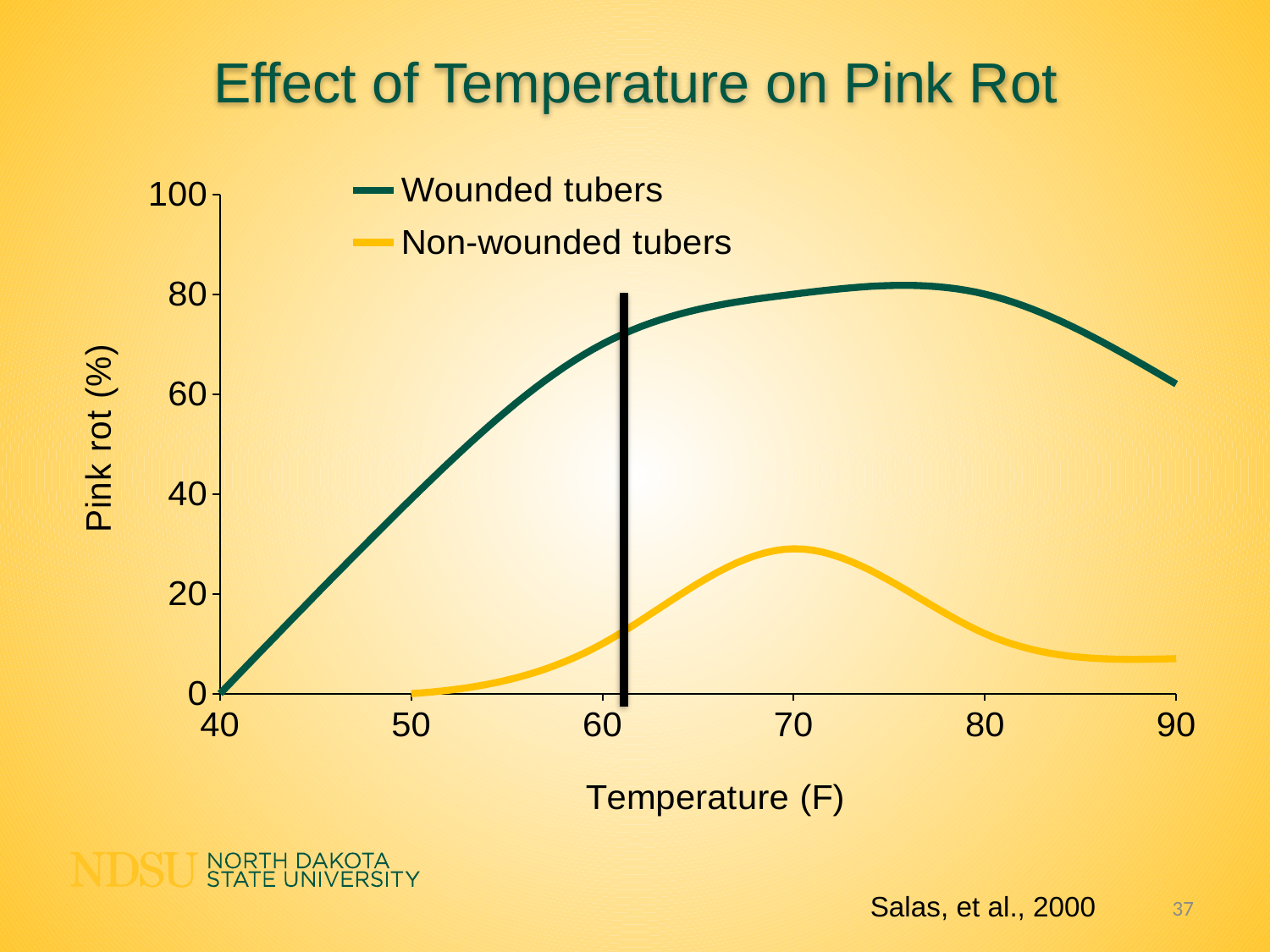
Is the value for Wounded tubers at 70 F greater or less than 60? greater What kind of chart is shown on the slide? Line chart Which series reaches the higher peak pink rot percentage? Wounded tubers Does the Non-wounded tubers line rise or fall between 70 F and 90 F? Fall Is the value for Non-wounded tubers at 90 F greater or less than 20? less What is the label of the x axis? Temperature (F) At 70 F, which series has the higher pink rot percentage, Wounded tubers or Non-wounded tubers? Wounded tubers Does the Wounded tubers line rise or fall between 40 F and 70 F? Rise Is the value for Wounded tubers at 90 F greater or less than 40? greater What is the title of the chart? Effect of Temperature on Pink Rot How many series does the legend list? 2